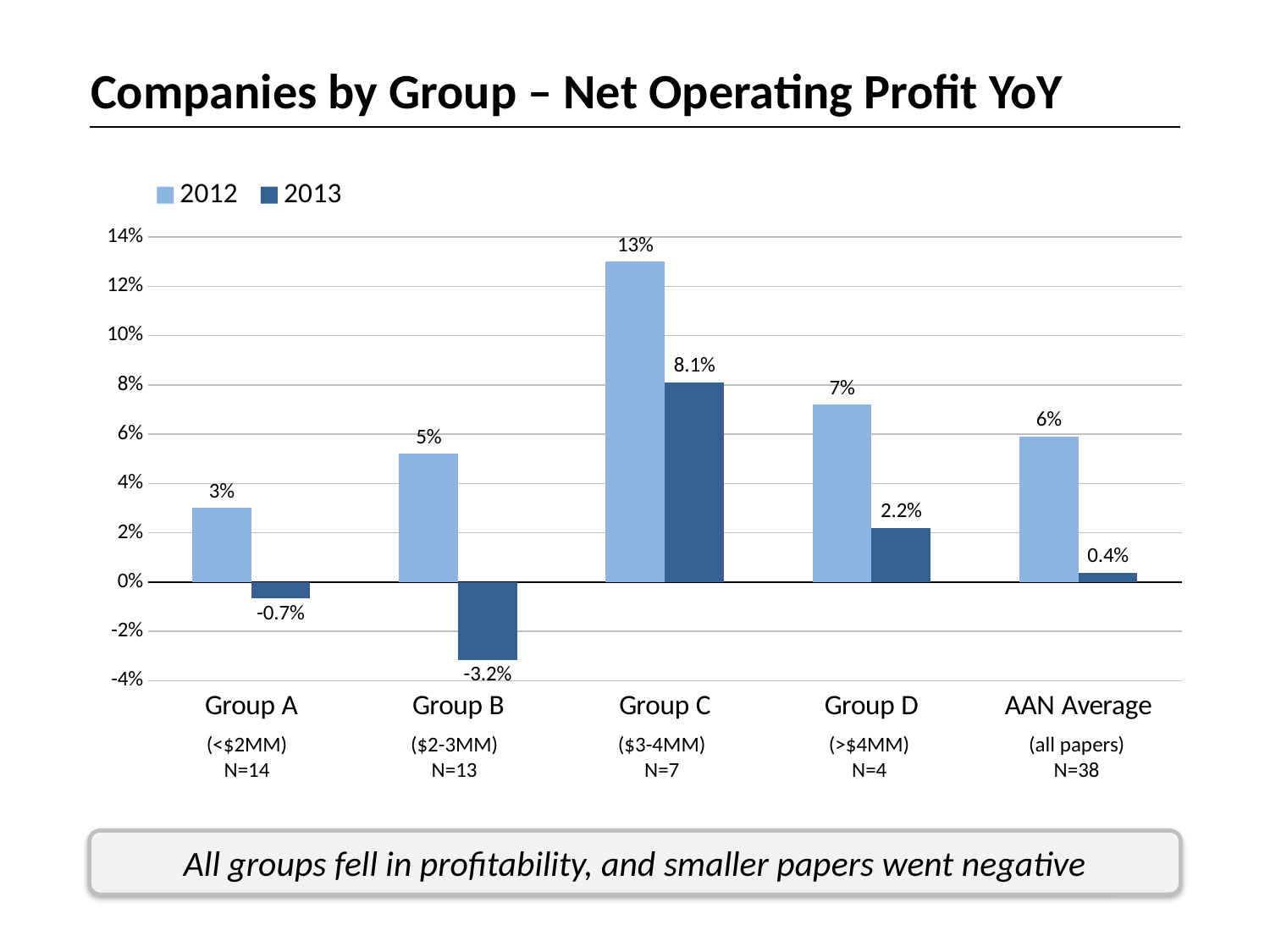
What is the difference between the 2013 values for Group C and Group D? 5.9% Which group has the lowest 2013 net operating profit? Group B Which is larger, the 2013 value for Group D or the 2013 value for the AAN Average? Group D What is the 2013 value for the AAN Average? 0.4% Which group has the highest 2012 net operating profit? Group C What is the 2013 net operating profit for Group C? 8.1% What is the 2012 net operating profit for Group A? 3% Is the 2012 value for Group B greater or less than 4%? greater How many series does the legend list? 2 What kind of chart is shown on the slide? Bar chart How many groups are shown on the x axis? 5 What is the 2013 value for Group B? -3.2%